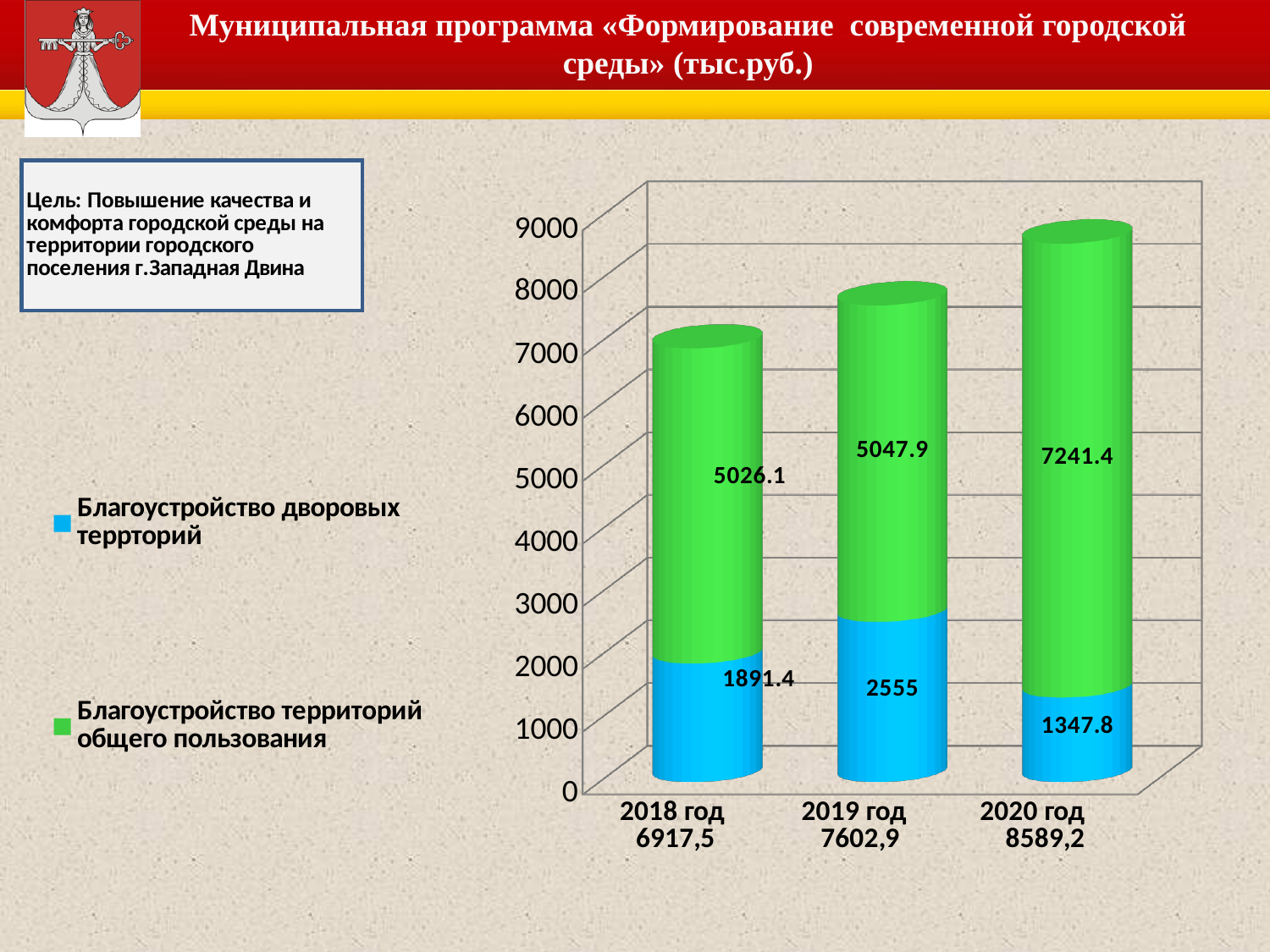
What is the difference between the Благоустройство территорий общего пользования values for 2020 год and 2019 год? 2193.5 In which year is the value for Благоустройство дворовых терpторий the lowest? 2020 год In which year is the value for Благоустройство территорий общего пользования the highest? 2020 год Which is larger: Благоустройство дворовых терpторий in 2019 год or in 2018 год? 2019 год How many series does the legend list? 2 How many years are shown on the x axis? 3 What is the value for Благоустройство дворовых терpторий in 2019 год? 2555 What is the total of the stacked bar for 2018 год? 6917,5 What kind of chart is shown on the slide? Stacked bar chart What is the value for Благоустройство дворовых терpторий in 2018 год? 1891.4 What is the total of the stacked bar for 2020 год? 8589,2 What is the value for Благоустройство территорий общего пользования in 2020 год? 7241.4